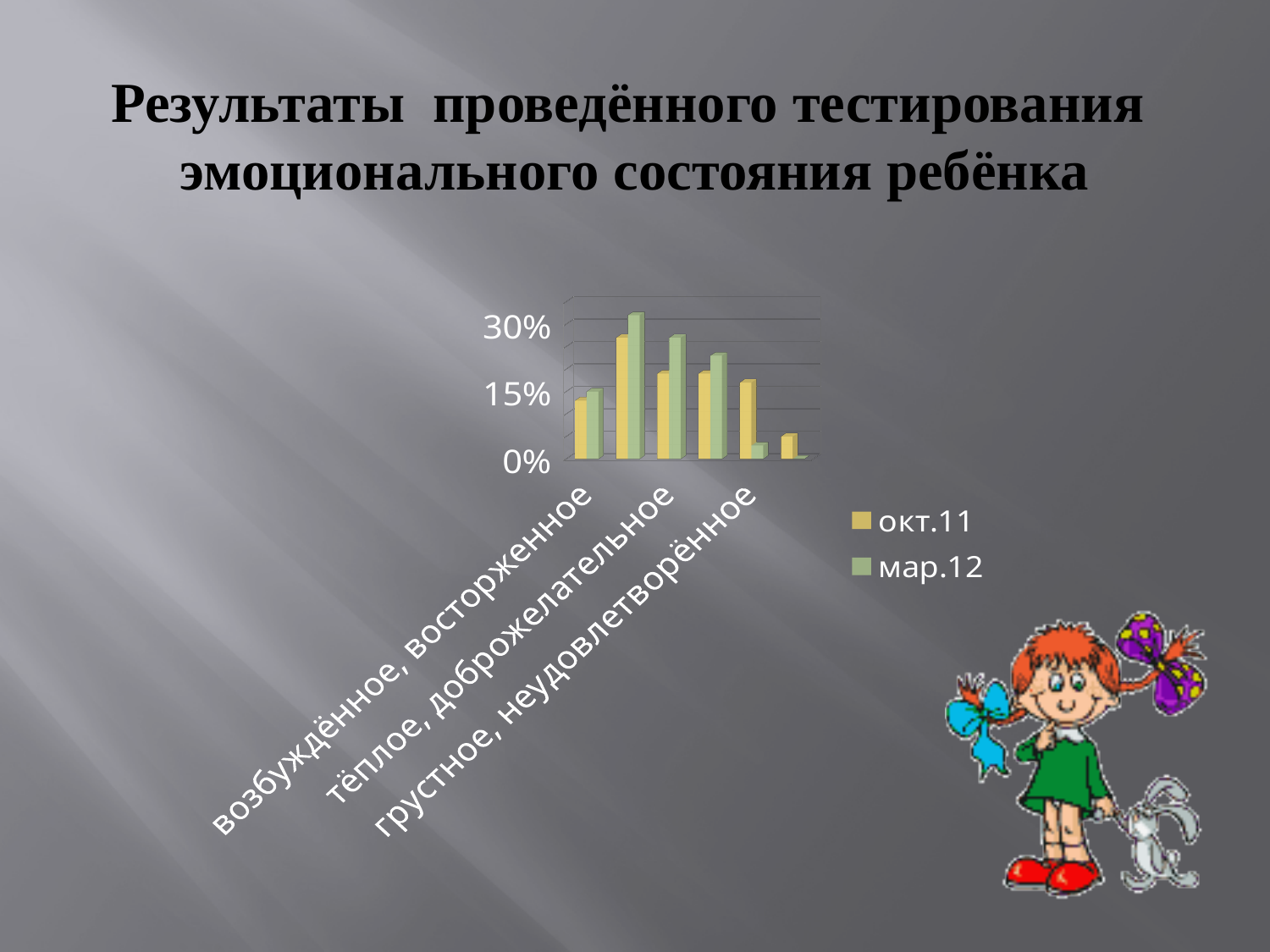
Is the мар.12 value for 'тёплое, доброжелательное' greater or less than 15%? greater Is the мар.12 value for 'тёплое, доброжелательное' greater or less than 30%? less For 'грустное, неудовлетворённое', which series has the larger value, окт.11 or мар.12? окт.11 For 'тёплое, доброжелательное', which series has the larger value, окт.11 or мар.12? мар.12 How many series does the chart legend list? 2 What are the two series named in the chart legend? окт.11 and мар.12 Is the окт.11 value for 'тёплое, доброжелательное' greater or less than 15%? greater What kind of chart is shown on the slide? bar chart Which of the three labelled categories has the highest мар.12 value? тёплое, доброжелательное For 'возбуждённое, восторженное', which series has the larger value, окт.11 or мар.12? мар.12